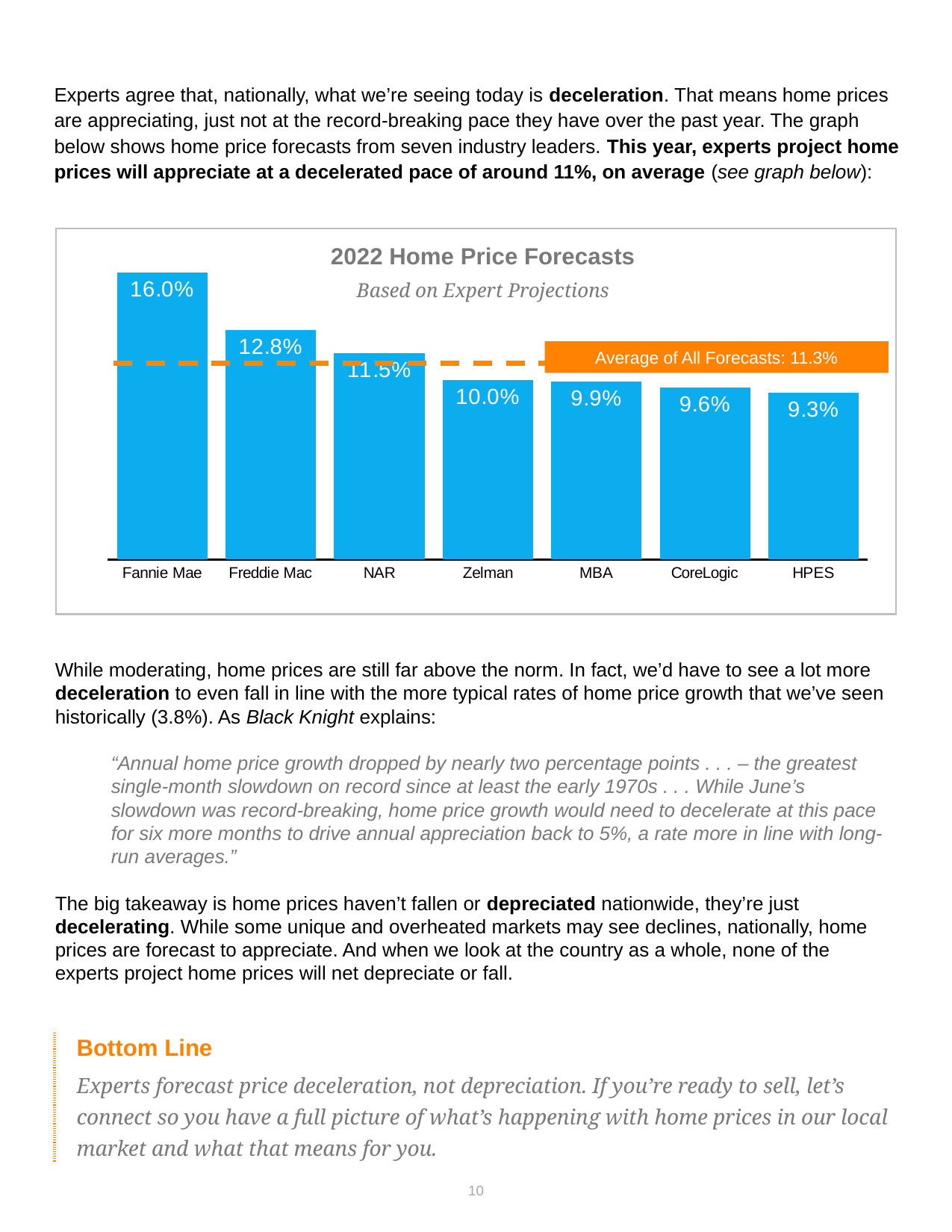
How many forecasters are shown in the chart? 7 What kind of chart is shown on the slide? Bar chart Which forecaster has the lowest 2022 home price forecast? HPES What is the 2022 home price forecast from Zelman? 10.0% Which forecaster has the highest 2022 home price forecast? Fannie Mae What is the 2022 home price forecast from Fannie Mae? 16.0% What is the 2022 home price forecast from CoreLogic? 9.6% Which forecast is larger, Freddie Mac or MBA? Freddie Mac What is the difference between the NAR and HPES forecasts? 2.2% What is the average of all forecasts shown on the chart? 11.3% What is the difference between the Fannie Mae and Freddie Mac forecasts? 3.2% Do the forecast values rise or fall from left to right across the chart? Fall